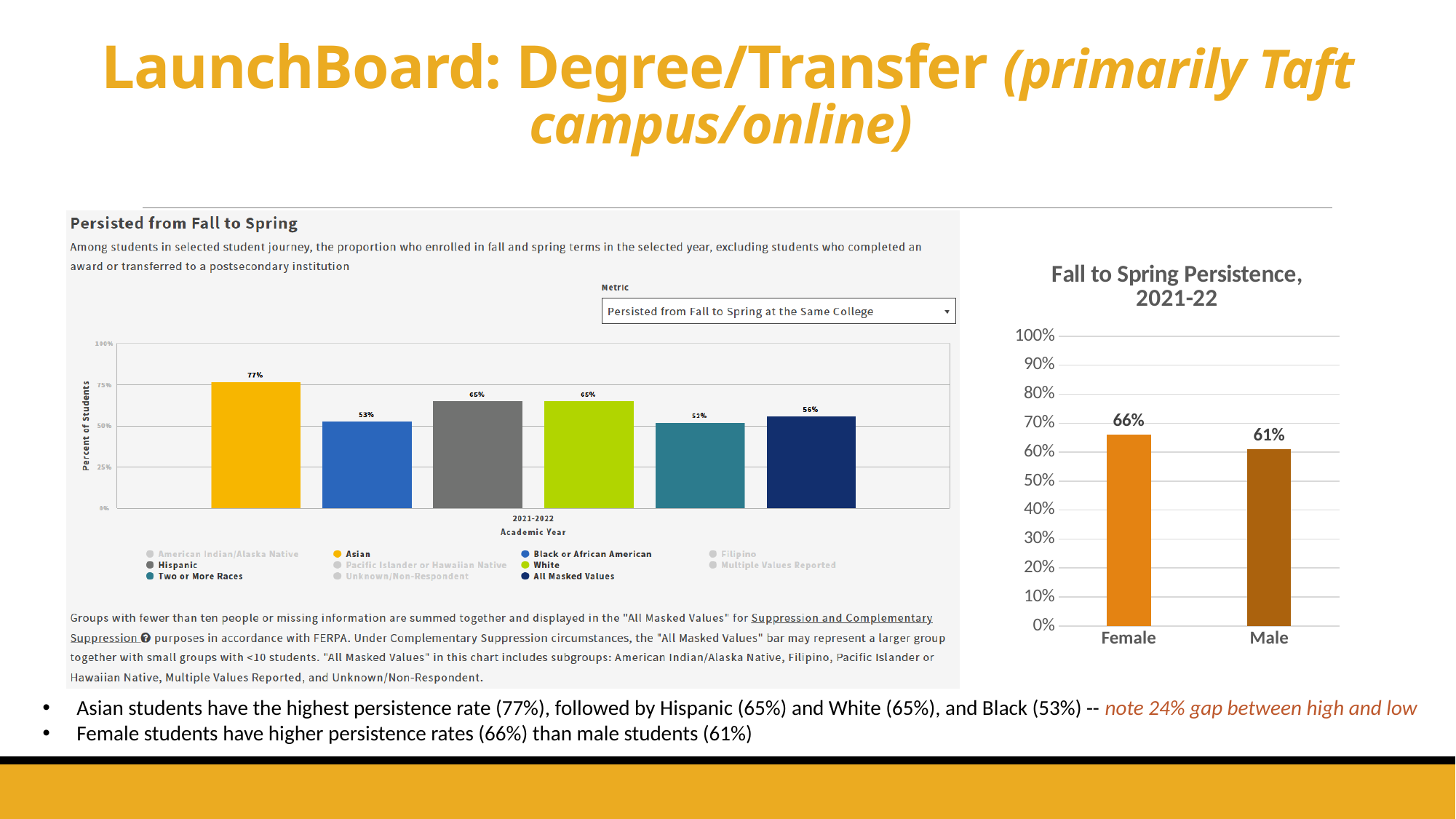
In the 'Persisted from Fall to Spring' chart, which group has the lowest persistence rate? Two or More Races What kind of chart is the 'Fall to Spring Persistence, 2021-22' chart? Bar chart In the 'Persisted from Fall to Spring' chart, what is the value for Asian students? 77% In the 'Persisted from Fall to Spring' chart, what is the value for All Masked Values? 56% In the 'Fall to Spring Persistence, 2021-22' chart, how many categories are shown? 2 In the 'Fall to Spring Persistence, 2021-22' chart, what is the value for Female? 66% In the 'Persisted from Fall to Spring' chart, what is the difference between the Asian and Black or African American values? 24% In the 'Fall to Spring Persistence, 2021-22' chart, which category has the higher value, Female or Male? Female In the 'Fall to Spring Persistence, 2021-22' chart, what is the value for Male? 61% In the 'Fall to Spring Persistence, 2021-22' chart, what is the difference between the Female and Male values? 5% In the 'Persisted from Fall to Spring' chart, which group has the highest persistence rate? Asian In the 'Persisted from Fall to Spring' chart, what is the value for Black or African American students? 53%